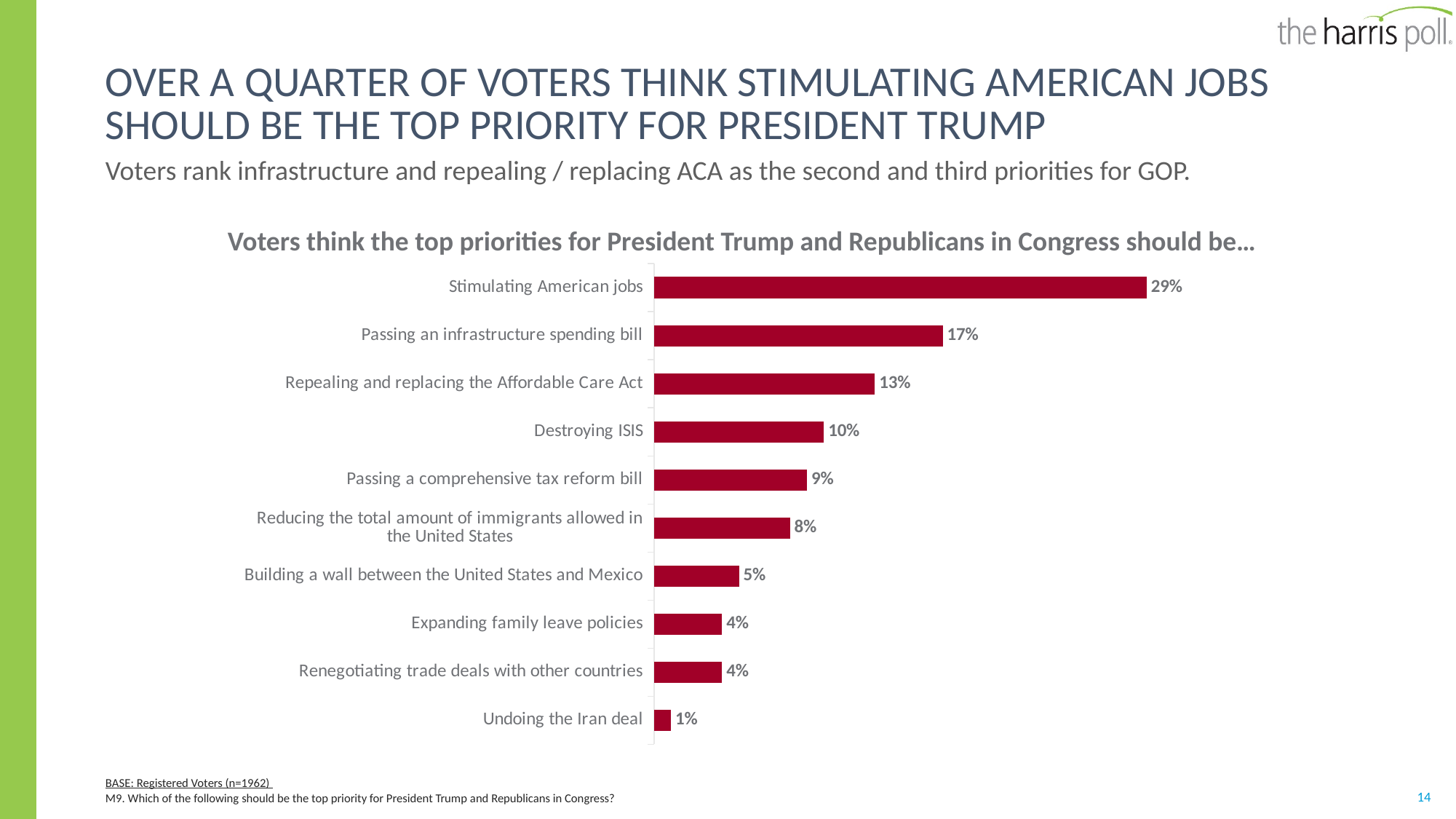
What is the difference between Passing an infrastructure spending bill and Repealing and replacing the Affordable Care Act? 4% What is the title of the chart? Voters think the top priorities for President Trump and Republicans in Congress should be… What kind of chart is shown on the slide? Bar chart How many priorities are shown in the chart? 10 Which priority has the highest percentage? Stimulating American jobs What is the difference between Stimulating American jobs and Passing an infrastructure spending bill? 12% Which priority has the lowest percentage? Undoing the Iran deal What percentage of voters think stimulating American jobs should be the top priority? 29% What is the value for Expanding family leave policies? 4% What is the value for Destroying ISIS? 10% Which is larger: Passing a comprehensive tax reform bill or Reducing the total amount of immigrants allowed in the United States? Passing a comprehensive tax reform bill What percentage chose Building a wall between the United States and Mexico? 5%